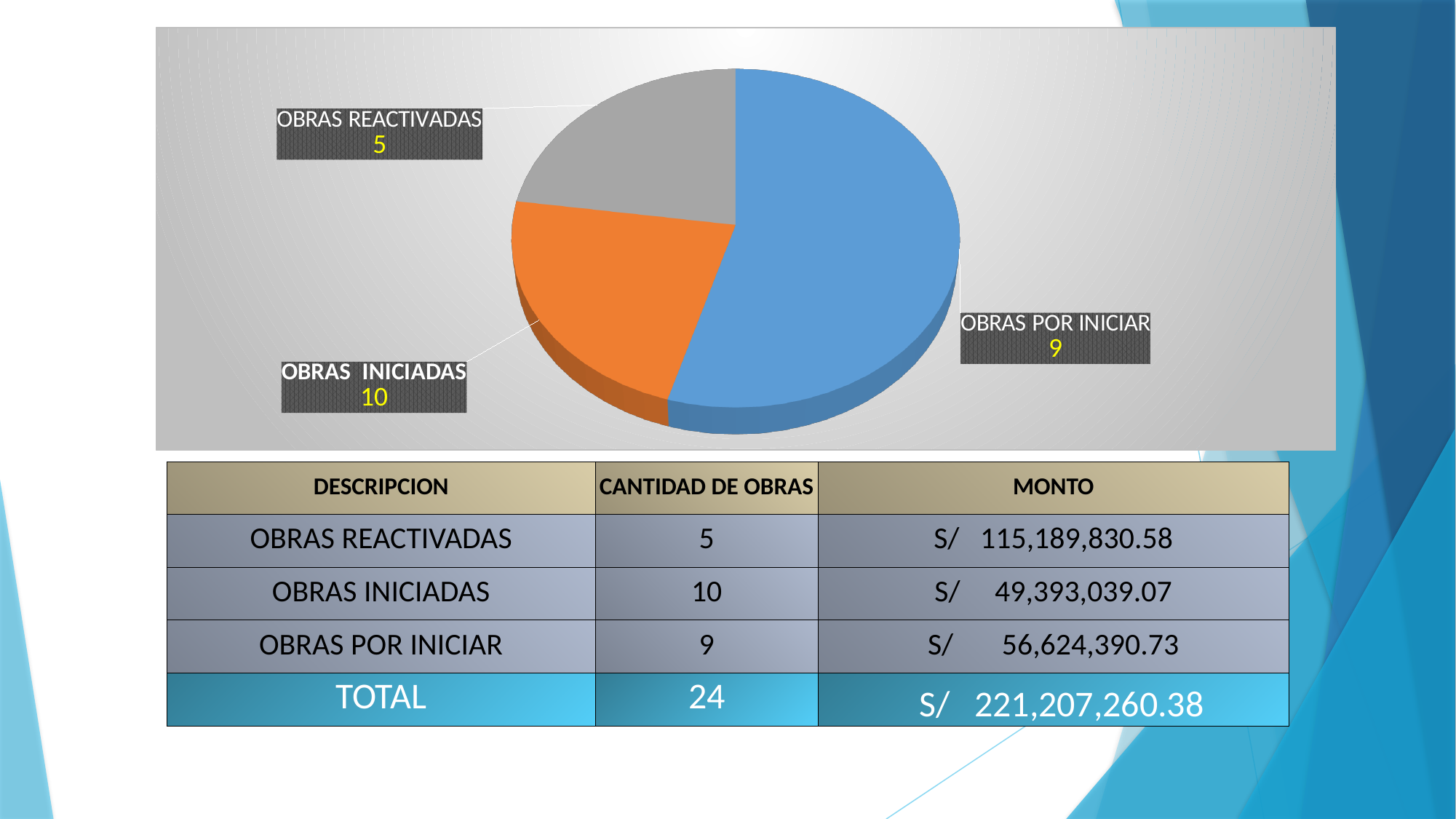
Which has a larger value in the pie chart, OBRAS REACTIVADAS or OBRAS INICIADAS? OBRAS INICIADAS What is the difference between the values for OBRAS POR INICIAR and OBRAS REACTIVADAS in the pie chart? 4 What kind of chart is shown on the slide? Pie chart What value is shown for OBRAS INICIADAS in the pie chart? 10 What colour is the OBRAS INICIADAS slice in the pie chart? Orange What is the difference between the values for OBRAS INICIADAS and OBRAS REACTIVADAS in the pie chart? 5 Which has a larger value in the pie chart, OBRAS POR INICIAR or OBRAS REACTIVADAS? OBRAS POR INICIAR What value is shown for OBRAS REACTIVADAS in the pie chart? 5 What value is shown for OBRAS POR INICIAR in the pie chart? 9 What is the sum of the three values labelled on the pie chart? 24 Which category does the blue slice of the pie chart represent? OBRAS POR INICIAR How many slices does the pie chart have? 3